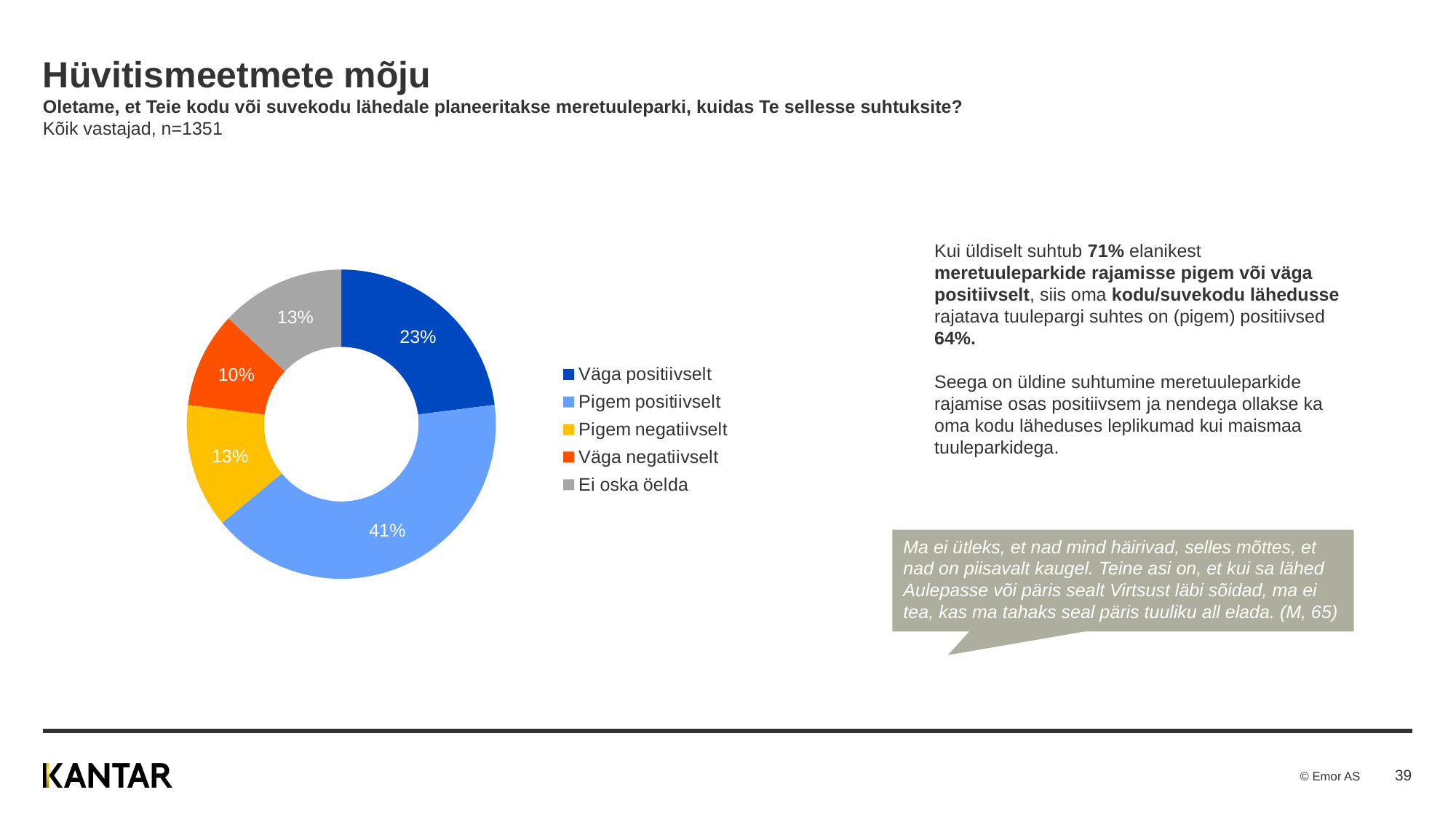
How many percentage points larger is the "Pigem positiivselt" share than the "Väga positiivselt" share? 18 percentage points What kind of chart is shown on the slide? Pie chart (donut) What share of respondents answered "Väga positiivselt"? 23% Which is larger: the share for "Väga positiivselt" or the share for "Pigem negatiivselt"? Väga positiivselt What share of respondents answered "Pigem positiivselt"? 41% Which response category has the largest share in the chart? Pigem positiivselt What share of respondents answered "Pigem negatiivselt"? 13% Which legend entry is shown in grey? Ei oska öelda What is the combined share of "Väga positiivselt" and "Pigem positiivselt"? 64% How many response categories does the chart show? 5 Which response category has the smallest share in the chart? Väga negatiivselt What share of respondents answered "Väga negatiivselt"? 10%